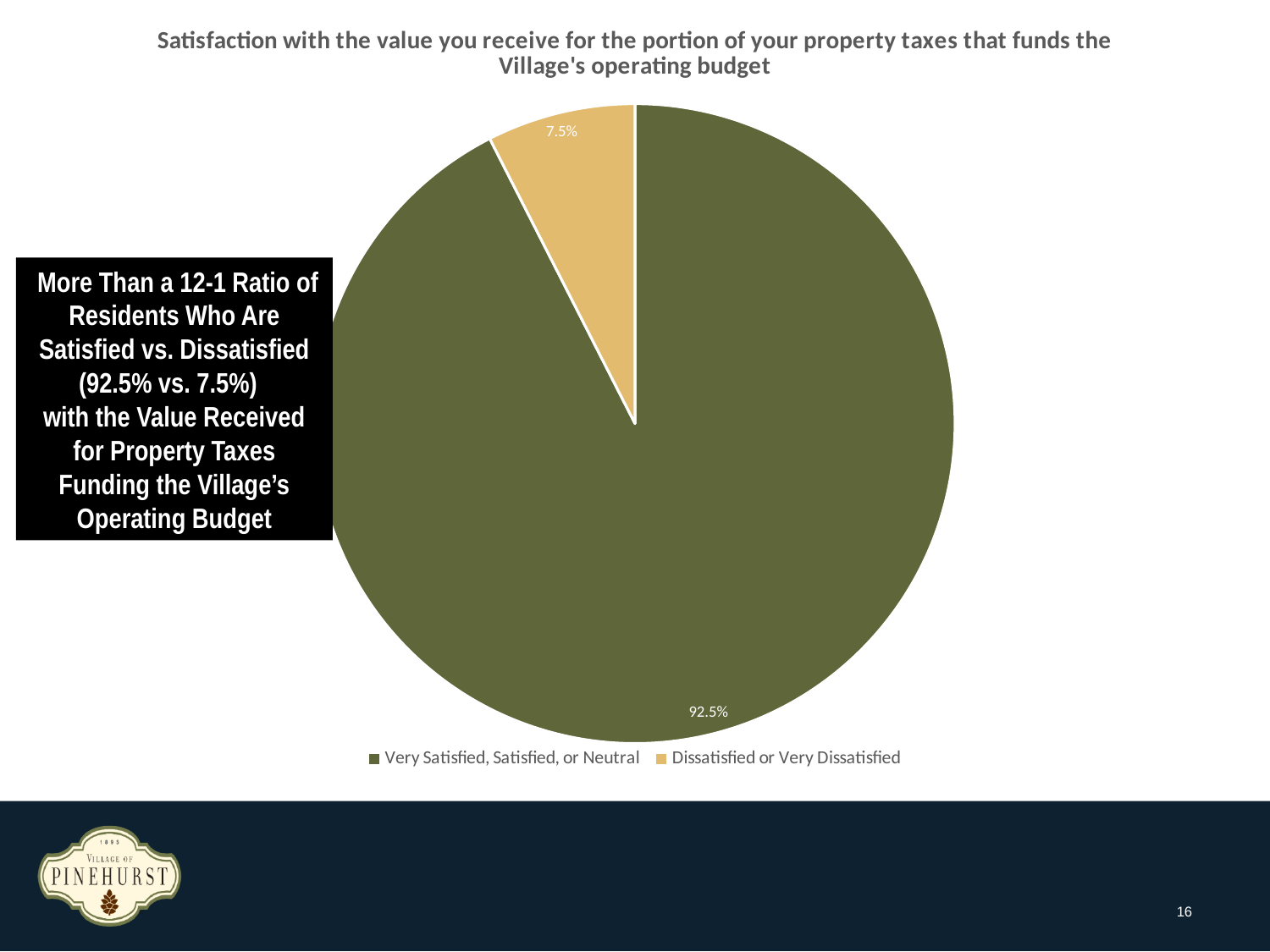
What is the title of the chart? Satisfaction with the value you receive for the portion of your property taxes that funds the Village's operating budget How many slices does the pie chart have? 2 What share of the pie is labelled "Very Satisfied, Satisfied, or Neutral"? 92.5% What colour is the "Dissatisfied or Very Dissatisfied" slice? Tan/gold What share of the pie is labelled "Dissatisfied or Very Dissatisfied"? 7.5% What is the difference in percentage points between the "Very Satisfied, Satisfied, or Neutral" slice and the "Dissatisfied or Very Dissatisfied" slice? 85 percentage points How many entries does the legend list? 2 What is the total of the two slice percentages shown on the pie chart? 100% Which slice of the pie is the smallest? Dissatisfied or Very Dissatisfied Which is larger: the "Dissatisfied or Very Dissatisfied" slice or the "Very Satisfied, Satisfied, or Neutral" slice? Very Satisfied, Satisfied, or Neutral What kind of chart is shown on the slide? Pie chart Which slice of the pie is the largest? Very Satisfied, Satisfied, or Neutral